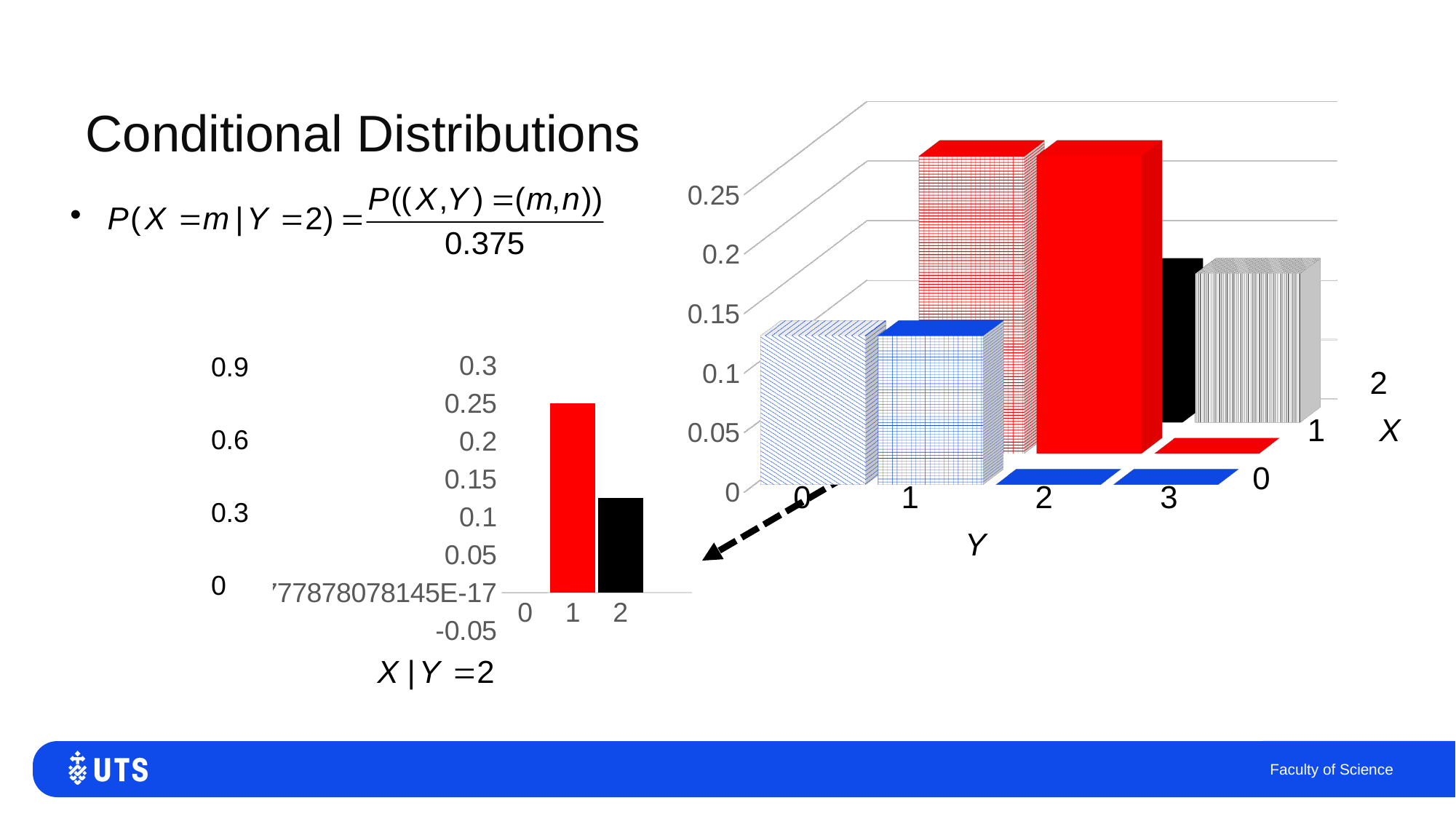
In the bottom-left chart labelled X | Y = 2, which is larger, the bar for category 1 or the bar for category 2? 1 In the bottom-left chart labelled X | Y = 2, what colour is the bar for category 1? red In the bottom-left chart labelled X | Y = 2, which category has the highest bar? 1 In the large chart on the right, how many values of X are labelled along the depth axis? 3 In the large chart on the right, is the value for Y = 0, X = 0 greater or less than 0.2? less In the bottom-left chart labelled X | Y = 2, how many categories are shown on the x axis? 3 In the bottom-left chart labelled X | Y = 2, what is the value for category 1? 0.25 In the large chart on the right, how many values of Y are labelled along the horizontal axis? 4 In the bottom-left chart labelled X | Y = 2, is the value for category 2 greater or less than 0.2? less What kind of chart is the small chart at the bottom left labelled X | Y = 2? bar chart In the bottom-left chart labelled X | Y = 2, is the value for category 2 greater or less than 0.05? greater What kind of chart is the large chart on the right of the slide? bar chart